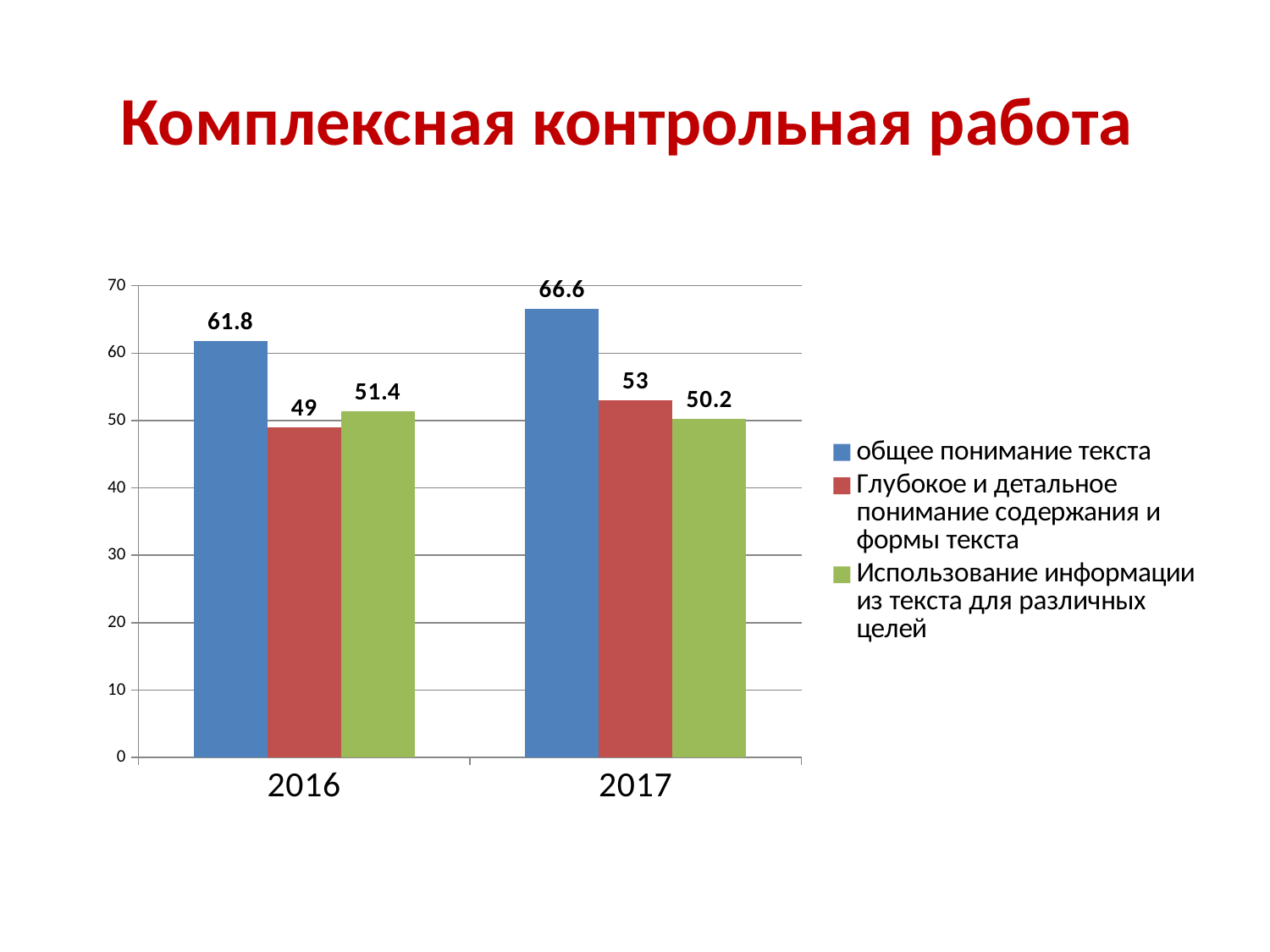
Which is larger: "Использование информации из текста для различных целей" in 2016 or in 2017? 2016 How many series does the legend list? 3 Does the value for "Глубокое и детальное понимание содержания и формы текста" rise or fall from 2016 to 2017? rise What kind of chart is shown on the slide? bar chart Is the value for "общее понимание текста" in 2017 greater or less than 60? greater Which series has the highest value in 2017? общее понимание текста By how much did the value for "общее понимание текста" change from 2016 to 2017? 4.8 Which series has the lowest value in 2016? Глубокое и детальное понимание содержания и формы текста What is the value for "Глубокое и детальное понимание содержания и формы текста" in 2017? 53 How many categories are shown on the x axis? 2 What is the value for "Использование информации из текста для различных целей" in 2016? 51.4 What is the value for "общее понимание текста" in 2016? 61.8